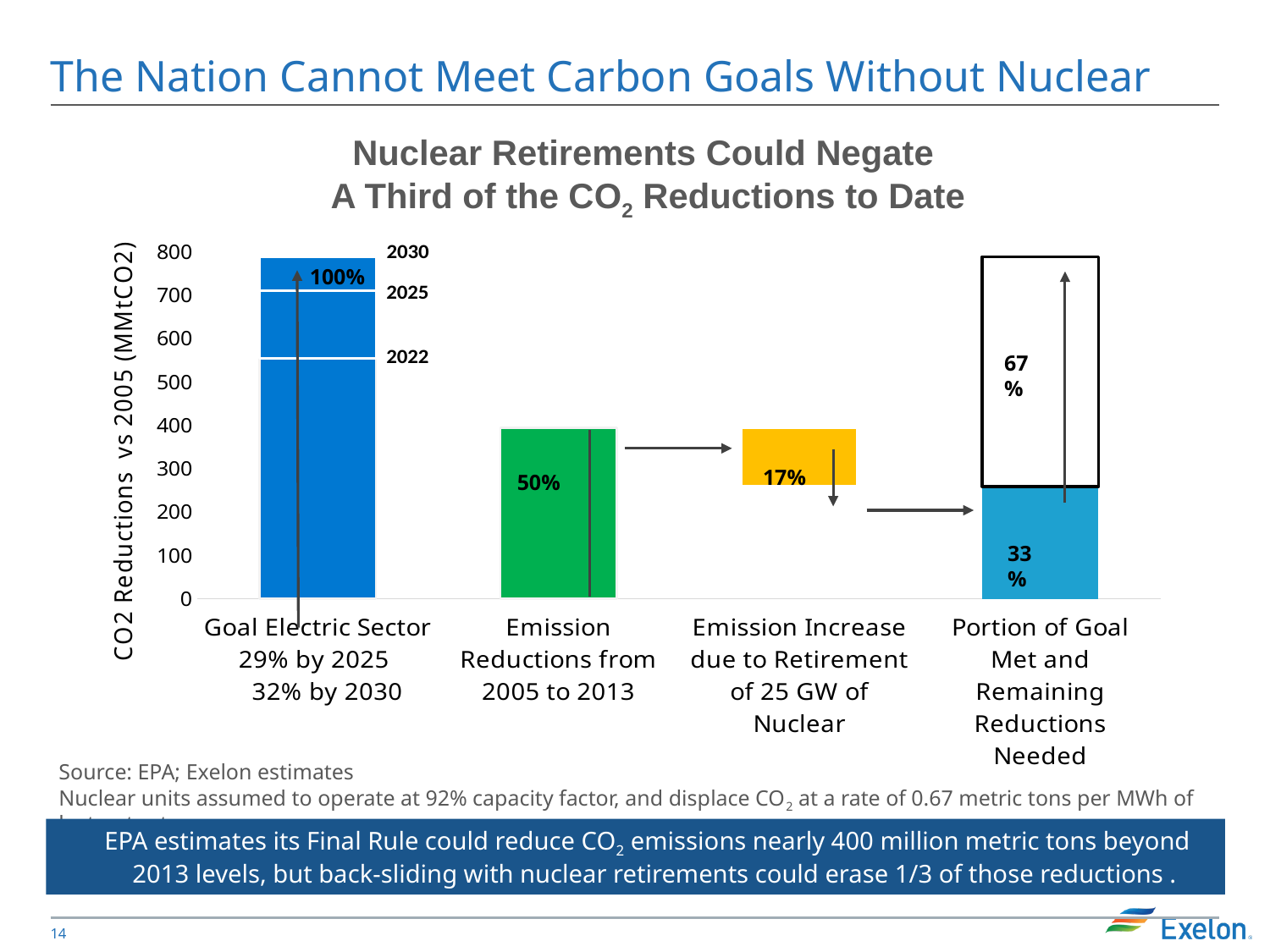
What kind of chart is shown on the slide? Bar chart What percentage label is shown on the 'Goal Electric Sector' bar? 100% In the 'Portion of Goal Met and Remaining Reductions Needed' bar, what percentage is labelled on the white (remaining reductions) portion? 67% What percentage label is shown on the 'Emission Reductions from 2005 to 2013' bar? 50% Is the top of the 'Goal Electric Sector' bar greater or less than 700 MMtCO2? greater Is the value for 'Emission Reductions from 2005 to 2013' greater or less than 300 MMtCO2? greater What is the label on the y axis of the chart? CO2 Reductions vs 2005 (MMtCO2) What percentage label is shown on the 'Emission Increase due to Retirement of 25 GW of Nuclear' bar? 17% Which bar is taller: 'Emission Reductions from 2005 to 2013' or 'Emission Increase due to Retirement of 25 GW of Nuclear'? Emission Reductions from 2005 to 2013 In the 'Portion of Goal Met and Remaining Reductions Needed' bar, what percentage is labelled on the blue (goal met) portion? 33% How many categories are shown along the x axis of the chart? 4